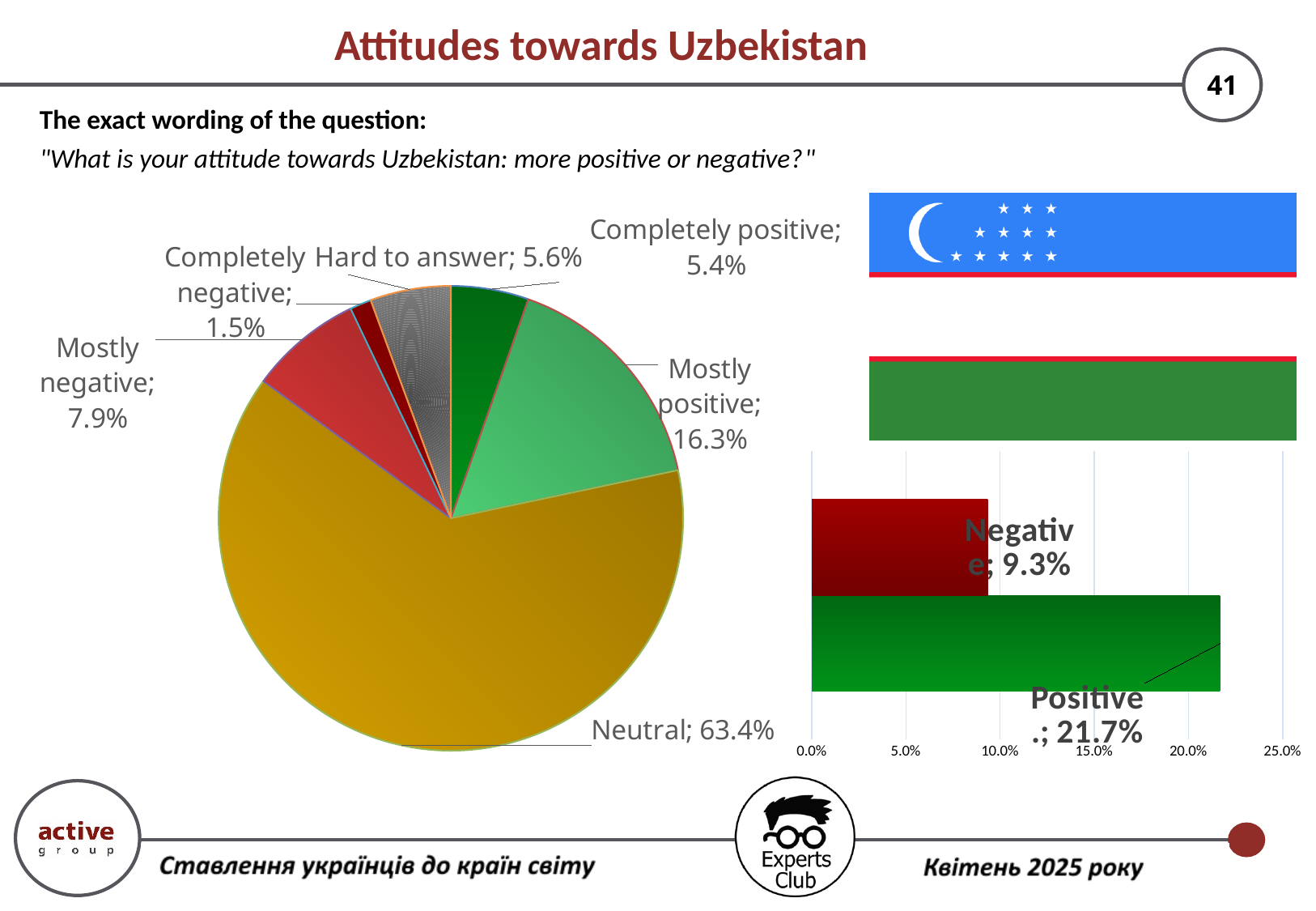
In the pie chart, what is the value for "Hard to answer"? 5.6% In the pie chart, which category has the smallest share? Completely negative In the pie chart, what is the difference between "Mostly positive" and "Mostly negative"? 8.4% In the pie chart, how many categories are shown? 6 In the bar chart on the right, what is the value for "Negative"? 9.3% In the pie chart, what is the value for "Mostly positive"? 16.3% In the bar chart on the right, what is the value for "Positive"? 21.7% In the pie chart, what share of respondents answered "Neutral"? 63.4% In the pie chart, what is the value for "Completely negative"? 1.5% In the pie chart, which category has the largest share? Neutral What type of chart is shown on the right side of the slide? Bar chart In the bar chart on the right, what is the difference between "Positive" and "Negative"? 12.4%